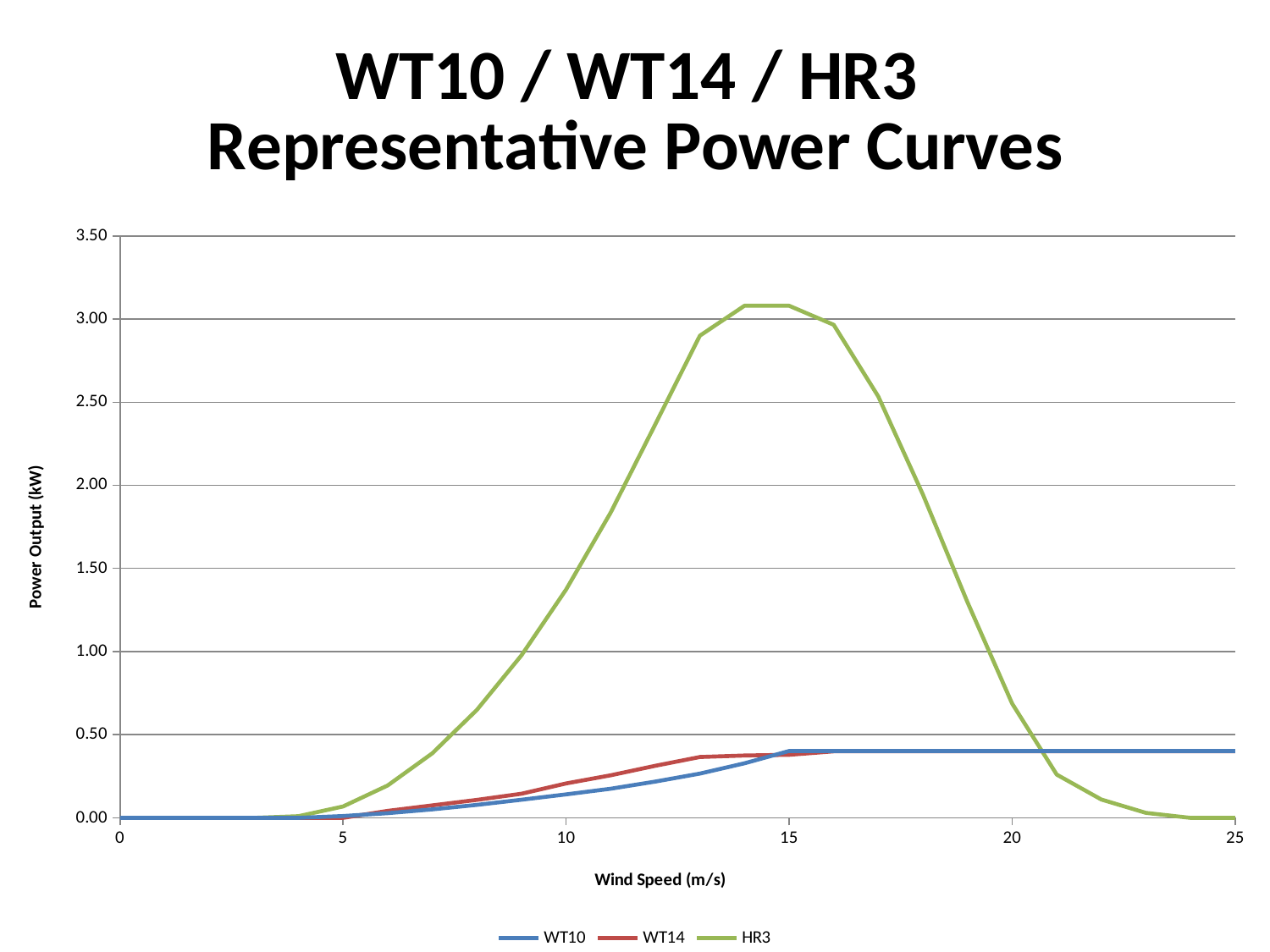
What are the names of the series listed in the legend? WT10, WT14, HR3 Is the value for HR3 at a wind speed of 25 m/s greater or less than 0.50? less What is the label of the y axis? Power Output (kW) At a wind speed of 10 m/s, which series has the higher power output, WT10 or WT14? WT14 How does the HR3 curve change as wind speed increases from 15 m/s to 25 m/s? It falls Is the value for HR3 at a wind speed of 10 m/s greater or less than 1.00? greater How many series does the legend list? 3 Which series reaches the highest power output? HR3 At a wind speed of 15 m/s, which series has the higher power output, HR3 or WT10? HR3 What kind of chart is shown on the slide? line chart Is the value for WT10 at a wind speed of 20 m/s greater or less than 0.50? less